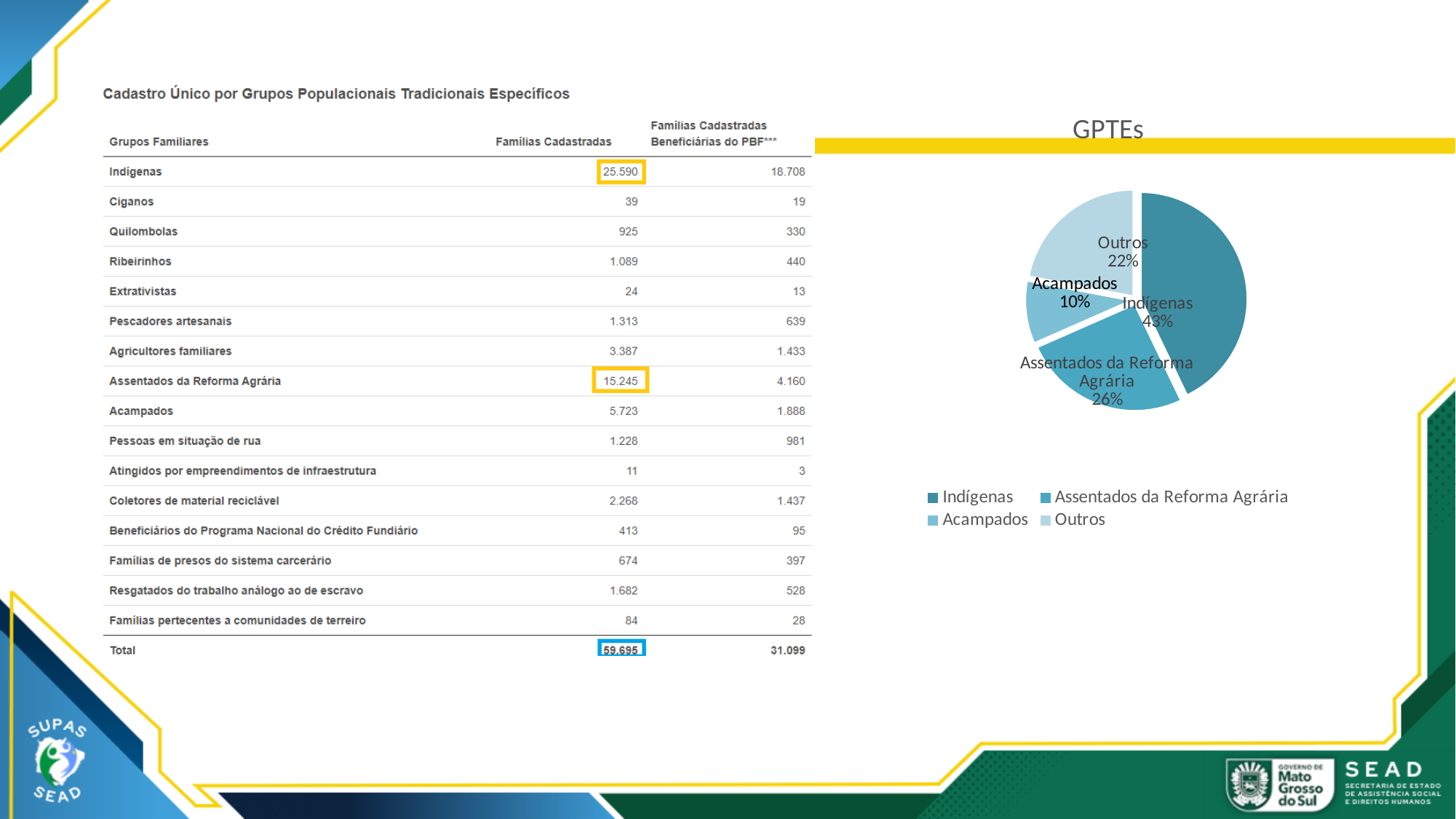
What percentage is shown for Acampados in the GPTEs pie chart? 10% How many slices does the GPTEs pie chart have? 4 How many entries does the legend of the GPTEs pie chart list? 4 What type of chart is the GPTEs chart? Pie chart What percentage does the Assentados da Reforma Agrária slice show in the GPTEs pie chart? 26% In the GPTEs pie chart, what is the difference in percentage points between Indígenas and Assentados da Reforma Agrária? 17 What share of the GPTEs pie chart is Indígenas? 43% Which slice of the GPTEs pie chart is the largest? Indígenas What is the title of the pie chart on the slide? GPTEs In the GPTEs pie chart, which is larger: Outros or Acampados? Outros What share of the GPTEs pie chart is labelled Outros? 22% Which slice of the GPTEs pie chart is the smallest? Acampados